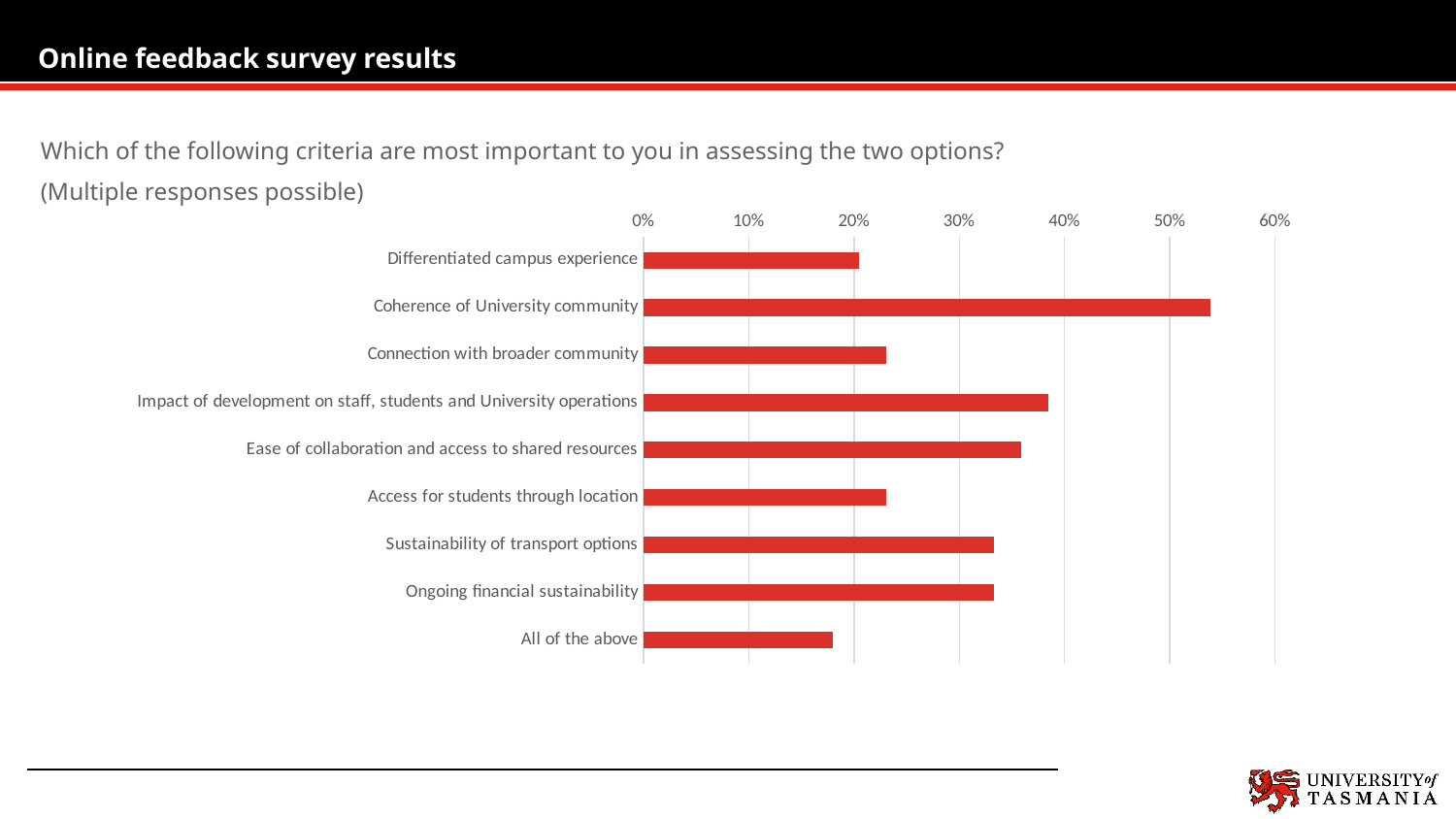
Is the value for Sustainability of transport options greater or less than 40%? less Is the value for Differentiated campus experience greater or less than 30%? less Is the value for Impact of development on staff, students and University operations greater or less than 30%? greater Which criterion has the lowest percentage of responses? All of the above Which has a larger value: Coherence of University community or Connection with broader community? Coherence of University community What is the highest value shown on the percentage axis of the chart? 60% Which has a larger value: Ease of collaboration and access to shared resources or Access for students through location? Ease of collaboration and access to shared resources How many criteria (categories) are plotted in the chart? 9 What kind of chart is shown on the slide? bar chart Which criterion has the highest percentage of responses? Coherence of University community